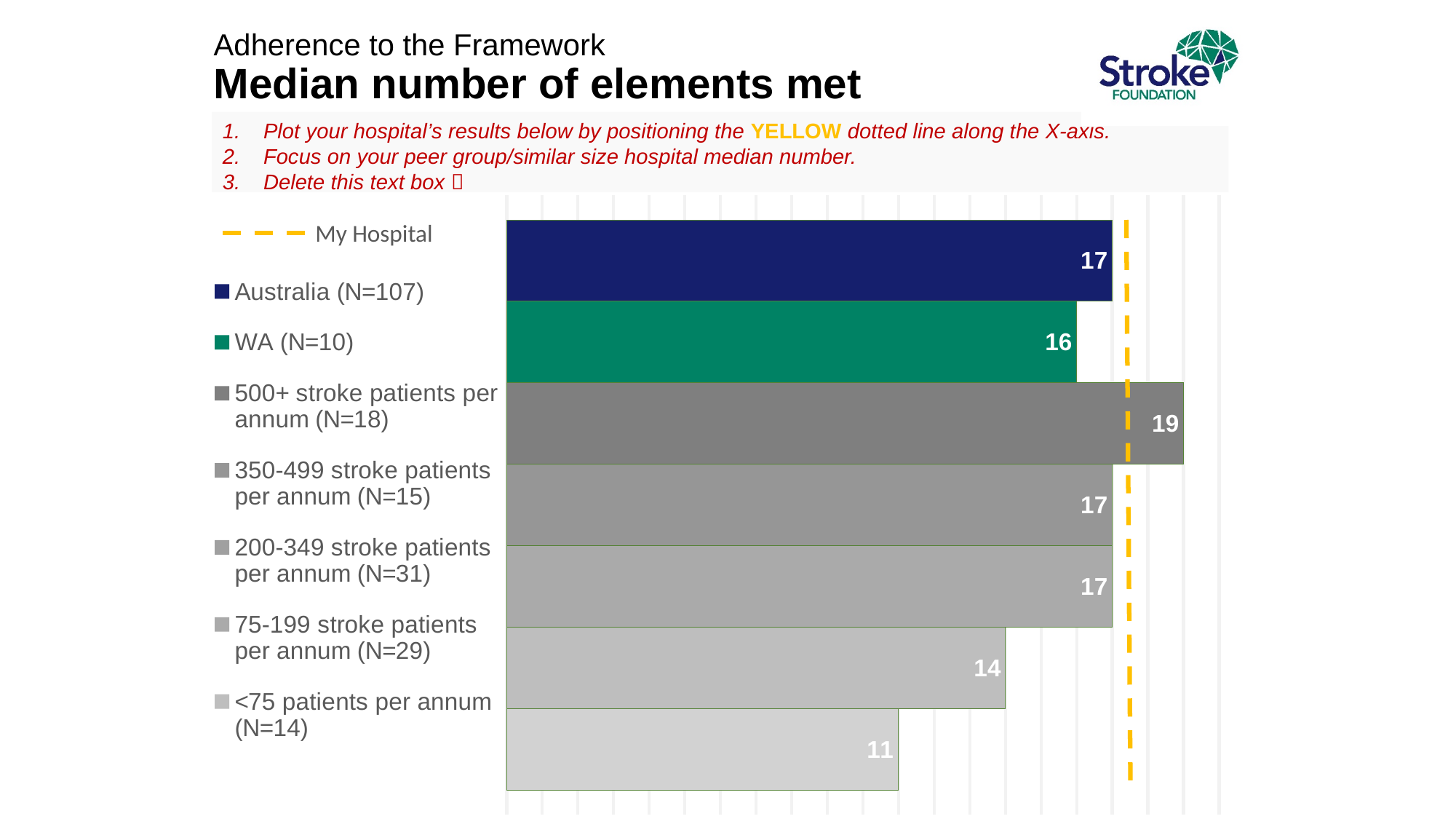
Which has a higher median number of elements met, Australia (N=107) or WA (N=10)? Australia (N=107) What is the difference between the median number of elements met for 500+ stroke patients per annum and <75 patients per annum? 8 What is the median number of elements met for WA (N=10)? 16 How many bars are plotted in the chart? 7 What is the median number of elements met for hospitals with 500+ stroke patients per annum (N=18)? 19 Which group has the highest median number of elements met? 500+ stroke patients per annum (N=18) What is the median number of elements met for hospitals with <75 patients per annum (N=14)? 11 What does the yellow dotted line in the legend represent? My Hospital Which group has the lowest median number of elements met? <75 patients per annum (N=14) What is the median number of elements met for Australia (N=107)? 17 What type of chart is shown on the slide? Bar chart What is the median number of elements met for hospitals with 75-199 stroke patients per annum (N=29)? 14